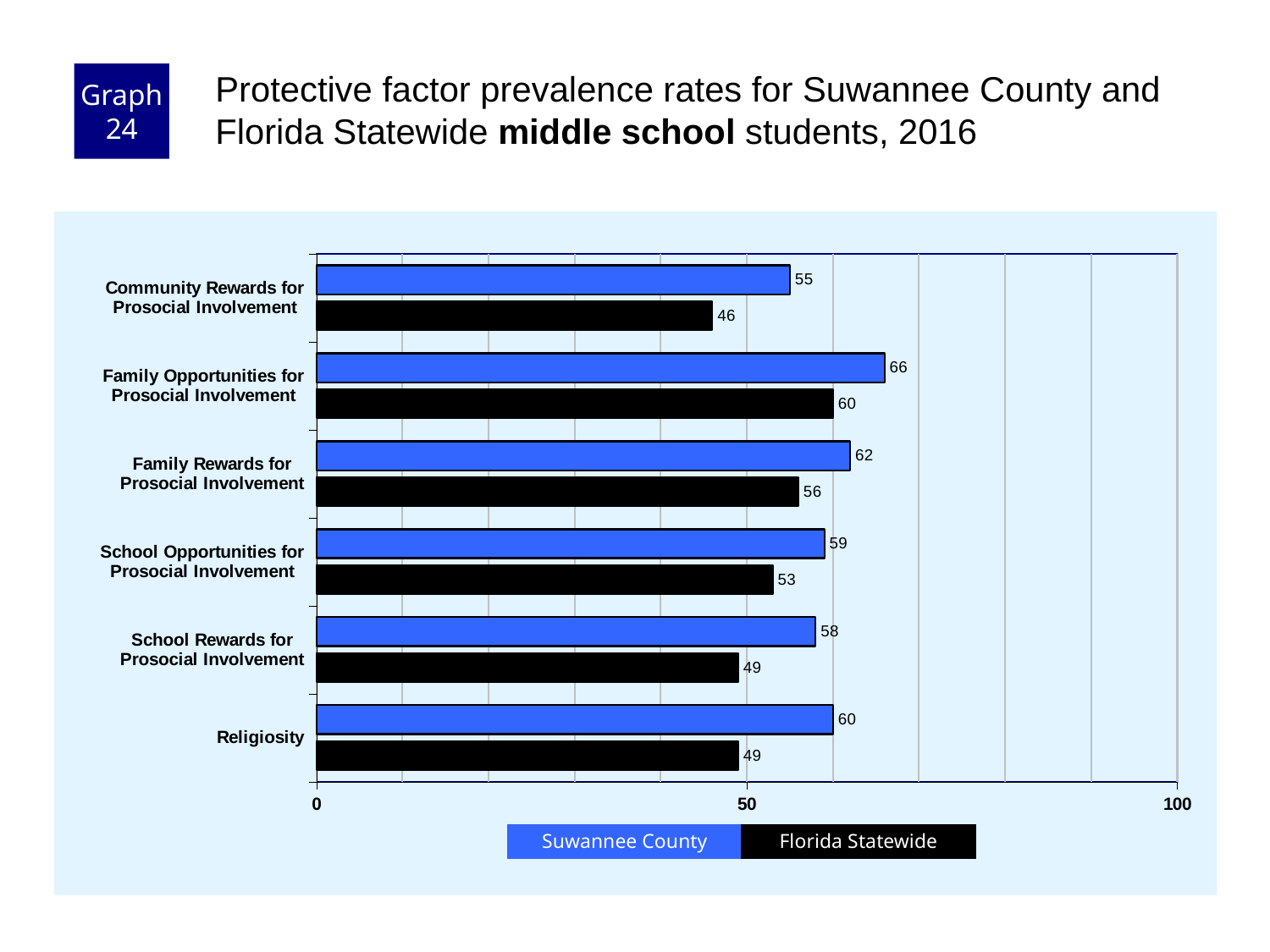
What is the Florida Statewide value for Community Rewards for Prosocial Involvement? 46 What is the Suwannee County value for Family Opportunities for Prosocial Involvement? 66 Which category has the lowest Florida Statewide value? Community Rewards for Prosocial Involvement Which is larger for Family Rewards for Prosocial Involvement: the Suwannee County value or the Florida Statewide value? Suwannee County Which category has the highest Suwannee County value? Family Opportunities for Prosocial Involvement How many series does the legend list? 2 Is the Florida Statewide value for School Rewards for Prosocial Involvement greater or less than 50? less What is the Florida Statewide value for Religiosity? 49 How many categories are shown on the chart? 6 What is the difference between the Suwannee County and Florida Statewide values for Religiosity? 11 What kind of chart is shown on the slide? bar chart What is the difference between the Suwannee County and Florida Statewide values for School Opportunities for Prosocial Involvement? 6